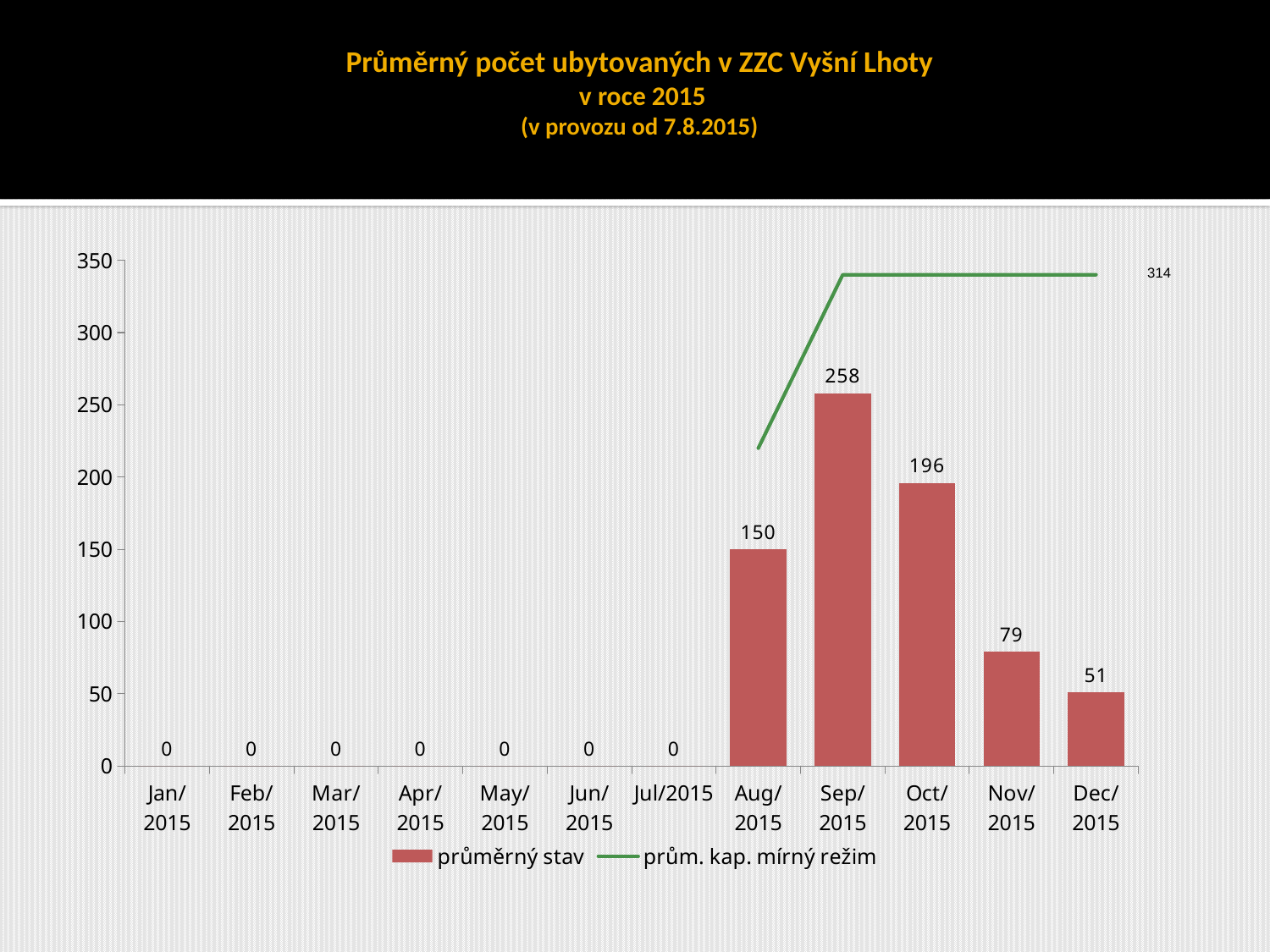
What is the value of průměrný stav for Aug/2015? 150 What is the difference between the průměrný stav values for Nov/2015 and Dec/2015? 28 Is the value of the prům. kap. mírný režim line for Aug/2015 greater or less than 200? greater Which is larger, the průměrný stav for Oct/2015 or for Aug/2015? Oct/2015 What is the difference between the průměrný stav values for Sep/2015 and Oct/2015? 62 Do the průměrný stav values rise or fall from Sep/2015 to Dec/2015? fall What is the value of průměrný stav for Dec/2015? 51 How many series does the legend list? 2 What is the value of průměrný stav for Sep/2015? 258 What kind of chart is used for the průměrný stav series? bar chart How many months are shown on the x axis? 12 Which month has the highest průměrný stav? Sep/2015